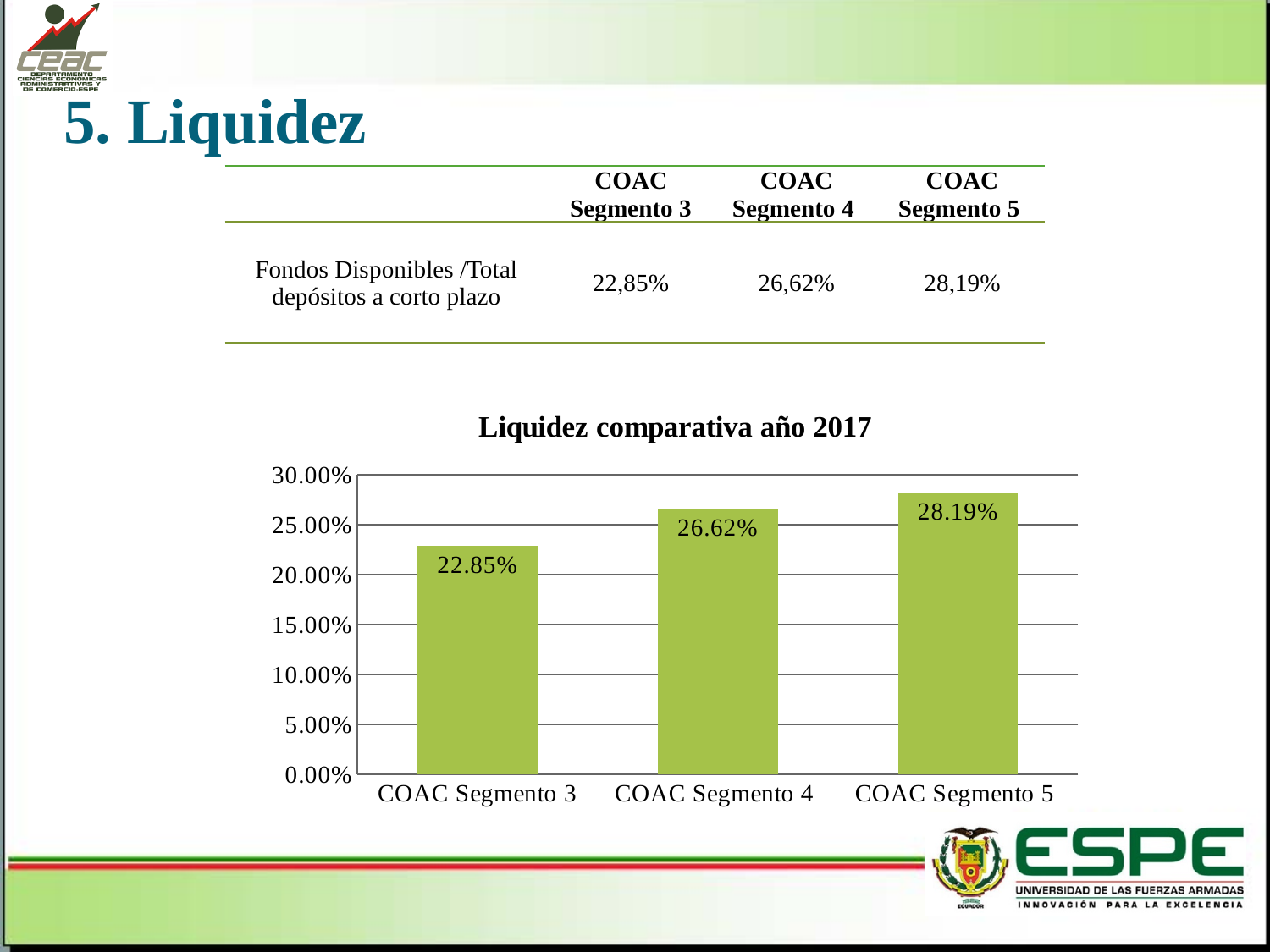
What is the value for COAC Segmento 3 in the chart? 22.85% What is the title of the chart? Liquidez comparativa año 2017 What is the value for COAC Segmento 4 in the chart? 26.62% Which category has the lowest value in the chart? COAC Segmento 3 Which is larger, the value for COAC Segmento 4 or COAC Segmento 3? COAC Segmento 4 Is the value for COAC Segmento 5 greater or less than 25.00%? greater Which category has the highest value in the chart? COAC Segmento 5 What is the difference between the values for COAC Segmento 5 and COAC Segmento 3? 5.34% What is the difference between the values for COAC Segmento 4 and COAC Segmento 3? 3.77% How many categories are shown in the chart? 3 What kind of chart is shown on the slide? bar chart What is the value for COAC Segmento 5 in the chart? 28.19%